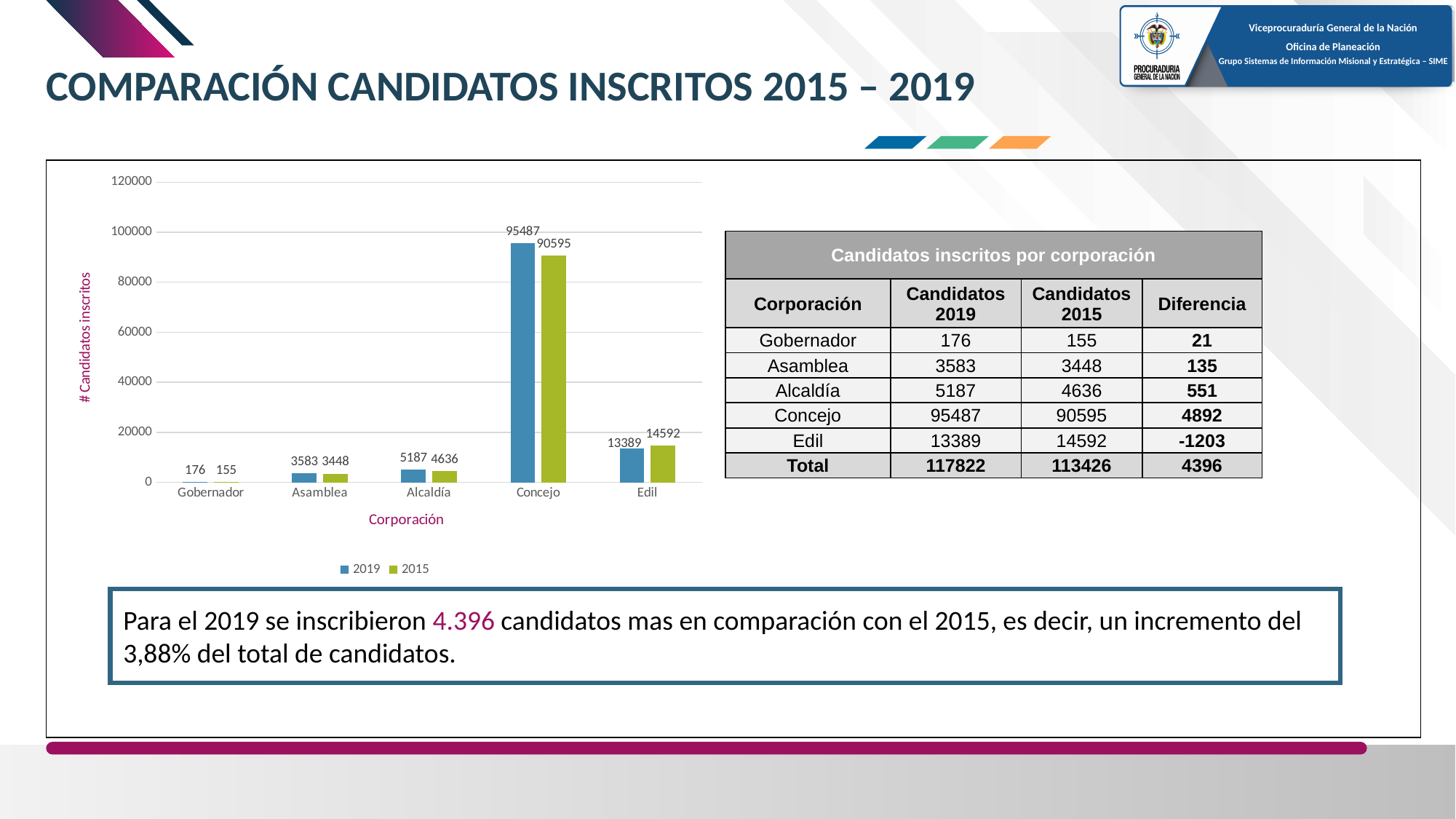
What is the value for Edil in the 2015 series? 14592 Is the value for Concejo in the 2015 series greater or less than 80000? greater What is the value for Gobernador in the 2019 series? 176 What is the difference between the 2019 and 2015 values for Concejo? 4892 Which is larger for Edil, the 2019 value or the 2015 value? 2015 What is the value for Concejo in the 2019 series? 95487 Which category has the lowest value in the 2015 series? Gobernador What kind of chart is shown on the slide? bar chart What is the difference between the 2015 and 2019 values for Edil? 1203 Which category has the highest value in the 2019 series? Concejo How many categories are shown on the x axis? 5 How many series does the legend list? 2